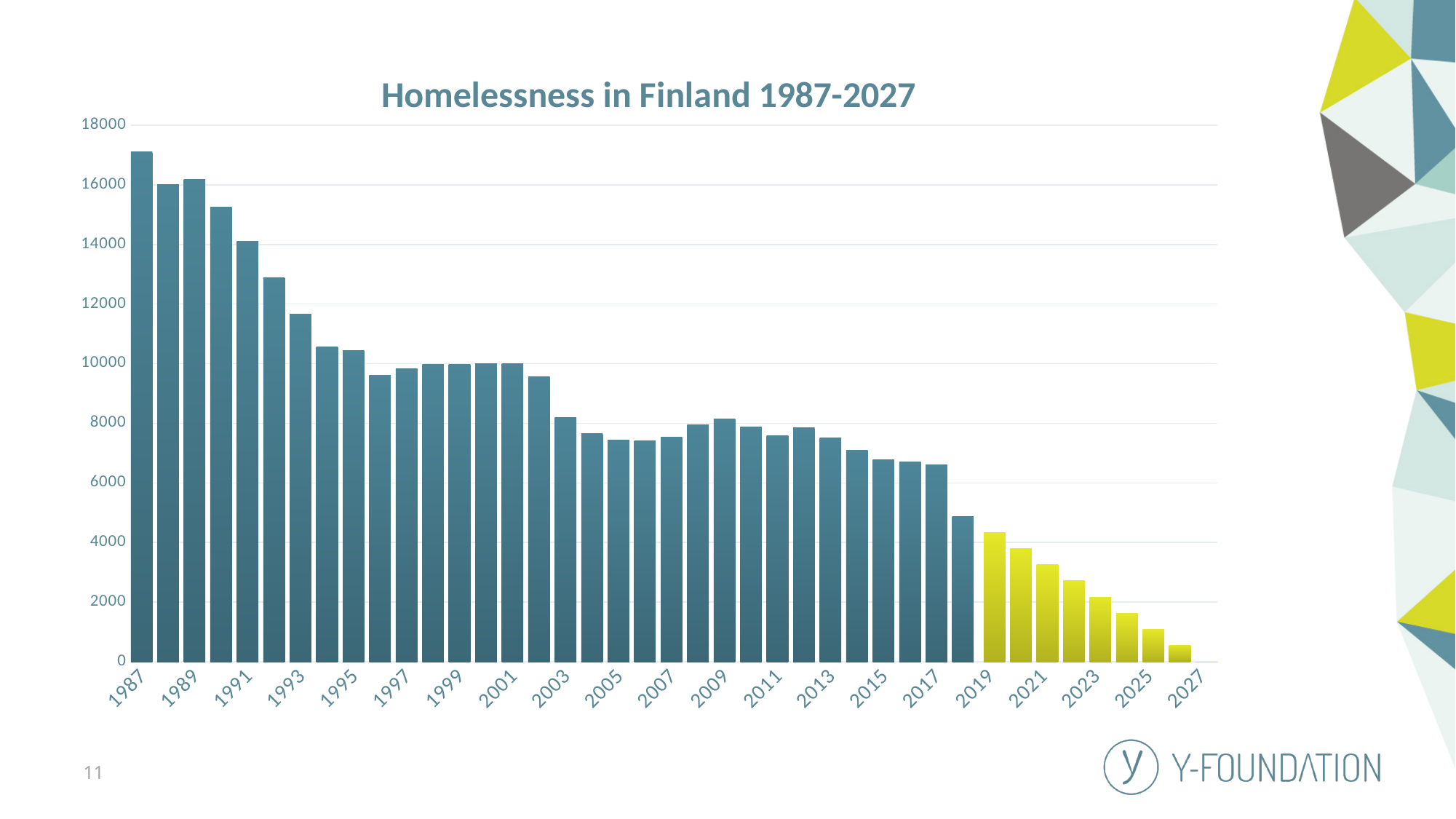
Is the value for 1987 greater or less than 16000? greater Is the value for 1993 greater or less than 12000? less Which year has the highest value in the chart? 1987 Is the value for 2027 greater or less than 2000? less Which year has the lowest value in the chart? 2027 Do the values generally rise or fall from 1987 to 2027? Fall What kind of chart is shown on the slide? Bar chart Which year has the larger value, 1987 or 1989? 1987 Which year has the larger value, 1995 or 2003? 1995 What is the title of the chart? Homelessness in Finland 1987-2027